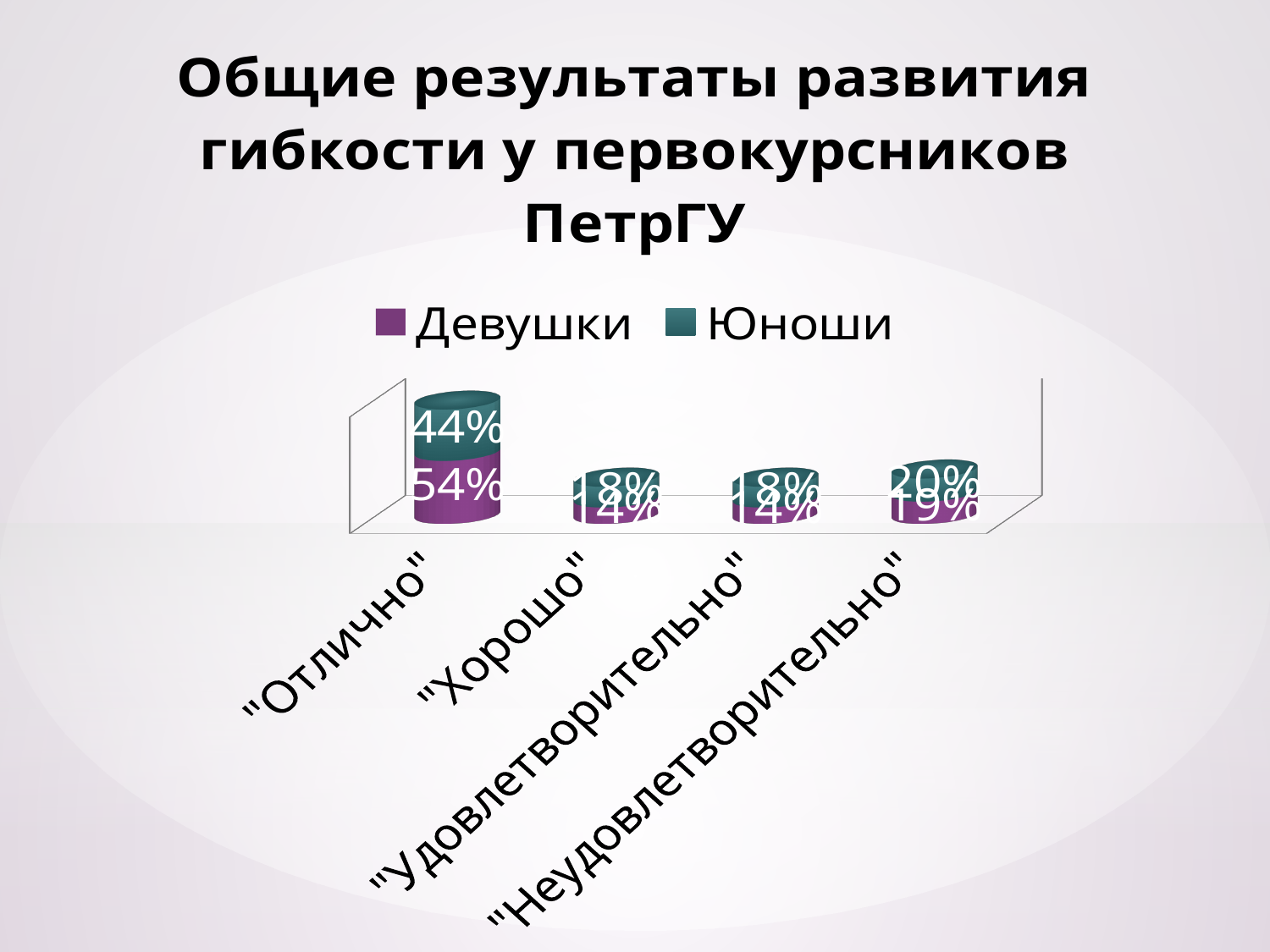
How many series does the legend list? 2 What kind of chart is shown on the slide? Stacked bar chart What is the value for Юноши in the "Отлично" category? 44% What is the value for Девушки in the "Отлично" category? 54% How many categories are shown on the x axis? 4 What is the difference between the Девушки and Юноши values in the "Отлично" category? 10% Which category has the highest value for Девушки? "Отлично" Which category has the highest value for Юноши? "Отлично" What is the value for Девушки in the "Неудовлетворительно" category? 19% In the "Отлично" category, which series has the larger value, Девушки or Юноши? Девушки What is the value for Юноши in the "Неудовлетворительно" category? 20% What is the total of the stacked bar for "Отлично"? 98%